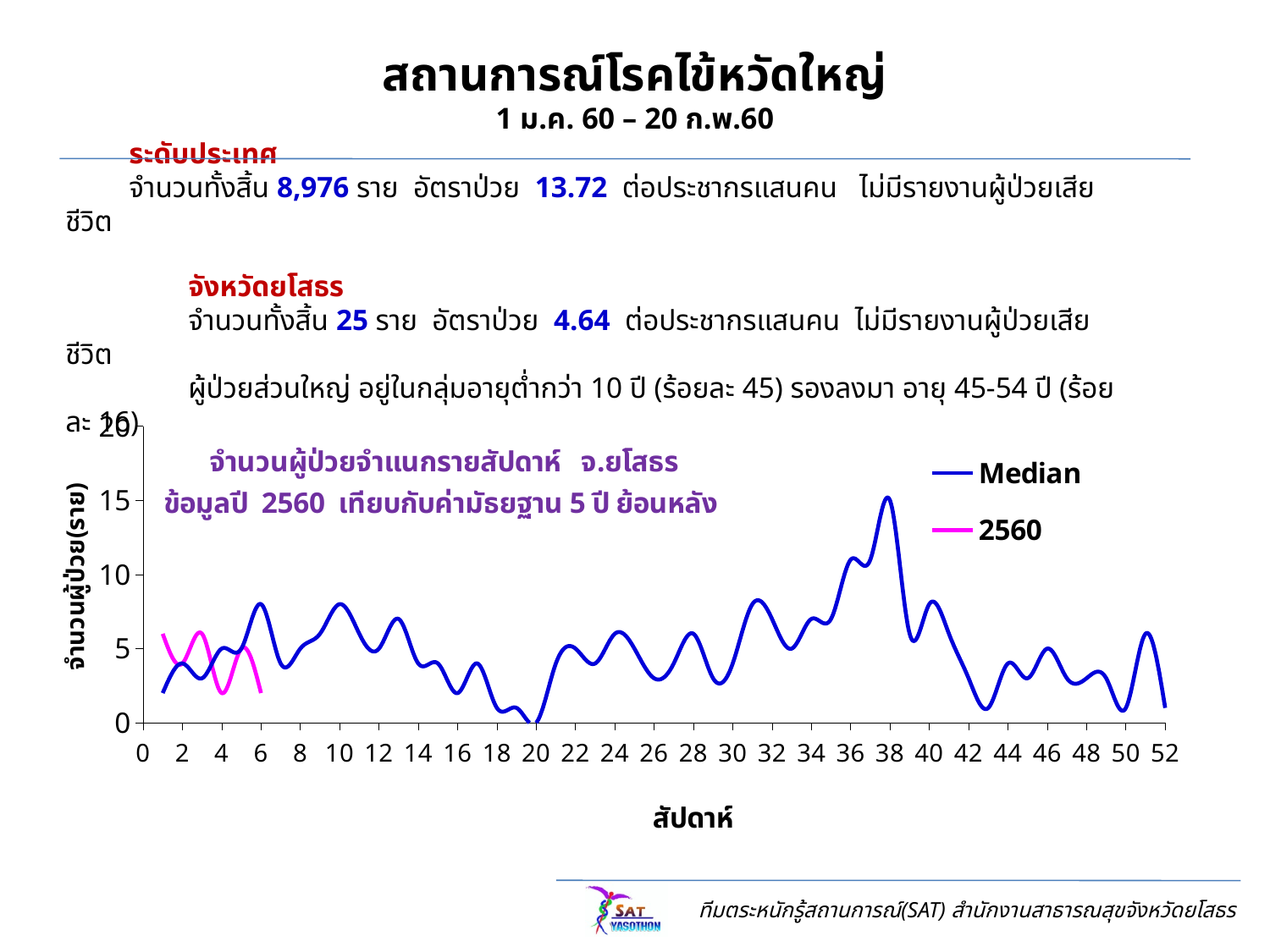
How many series does the chart legend list? 2 Does the Median series rise or fall between week 38 and week 43? fall Is the Median value at week 20 greater or less than 5? less Is the Median value at week 10 greater or less than 5? greater At which week does the Median series reach its lowest value? 20 Is the 2560 value at week 6 greater or less than 5? less At week 1, which series has the larger value, Median or 2560? 2560 What is the title of the vertical axis of the chart? จำนวนผู้ป่วย(ราย) What kind of chart is shown on the slide? line chart What are the two series named in the chart legend? Median and 2560 At which week does the Median series reach its highest value? 38